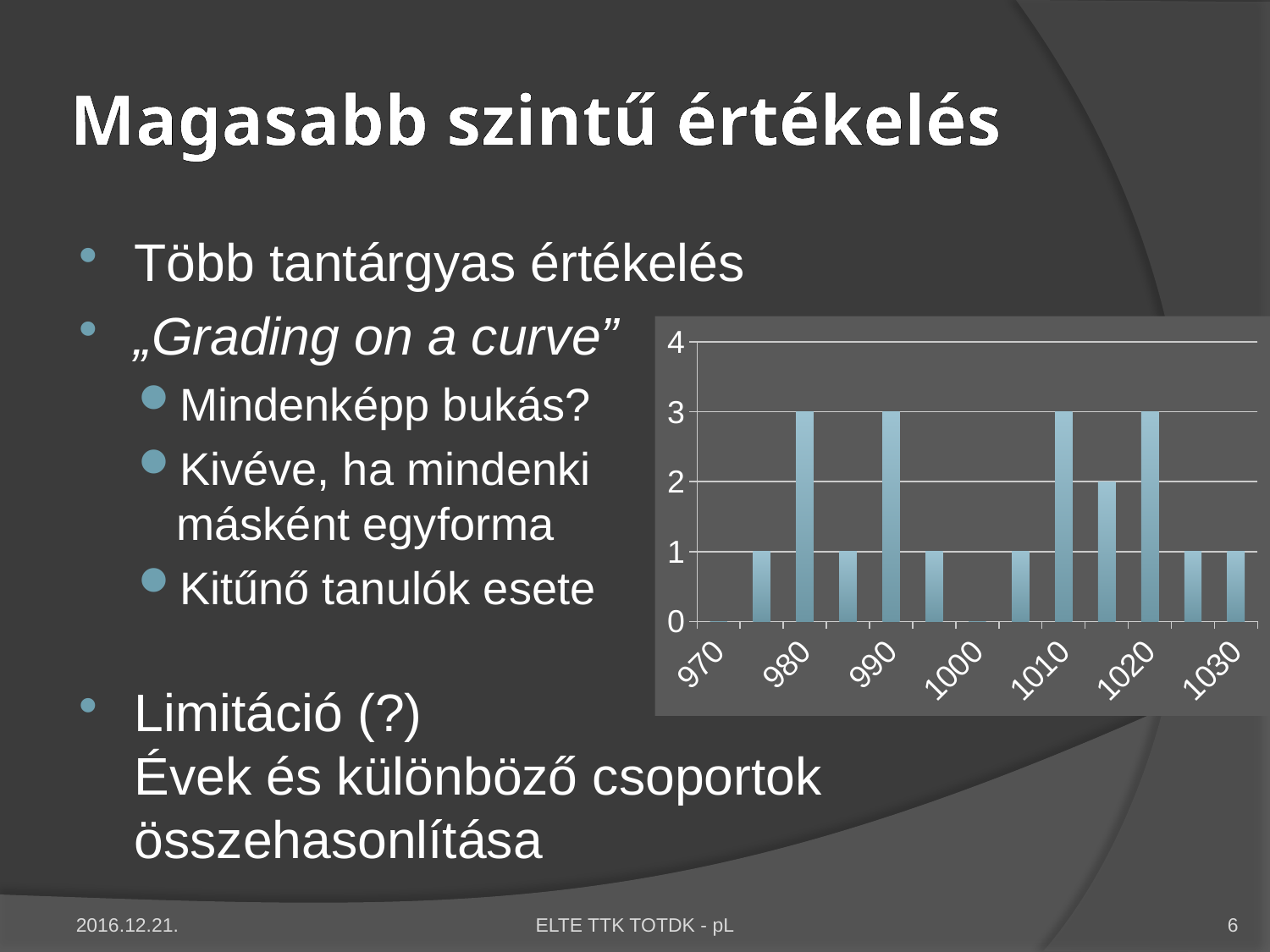
What is the highest value reached by any bar in the chart? 3 Which is larger, the value at 1020 or the value at 1030? 1020 What is the value of the bar at 1030? 1 Is the value at 990 greater or less than 2? greater What is the first label on the x axis of the chart? 970 What is the maximum value shown on the y axis of the chart? 4 What is the value of the bar at 980? 3 What is the value of the bar at 1010? 3 How many labels are printed on the x axis of the chart? 7 What kind of chart is shown on the slide? bar chart What is the value of the bar at 1000? 0 What is the difference between the value at 1020 and the value at 1030? 2